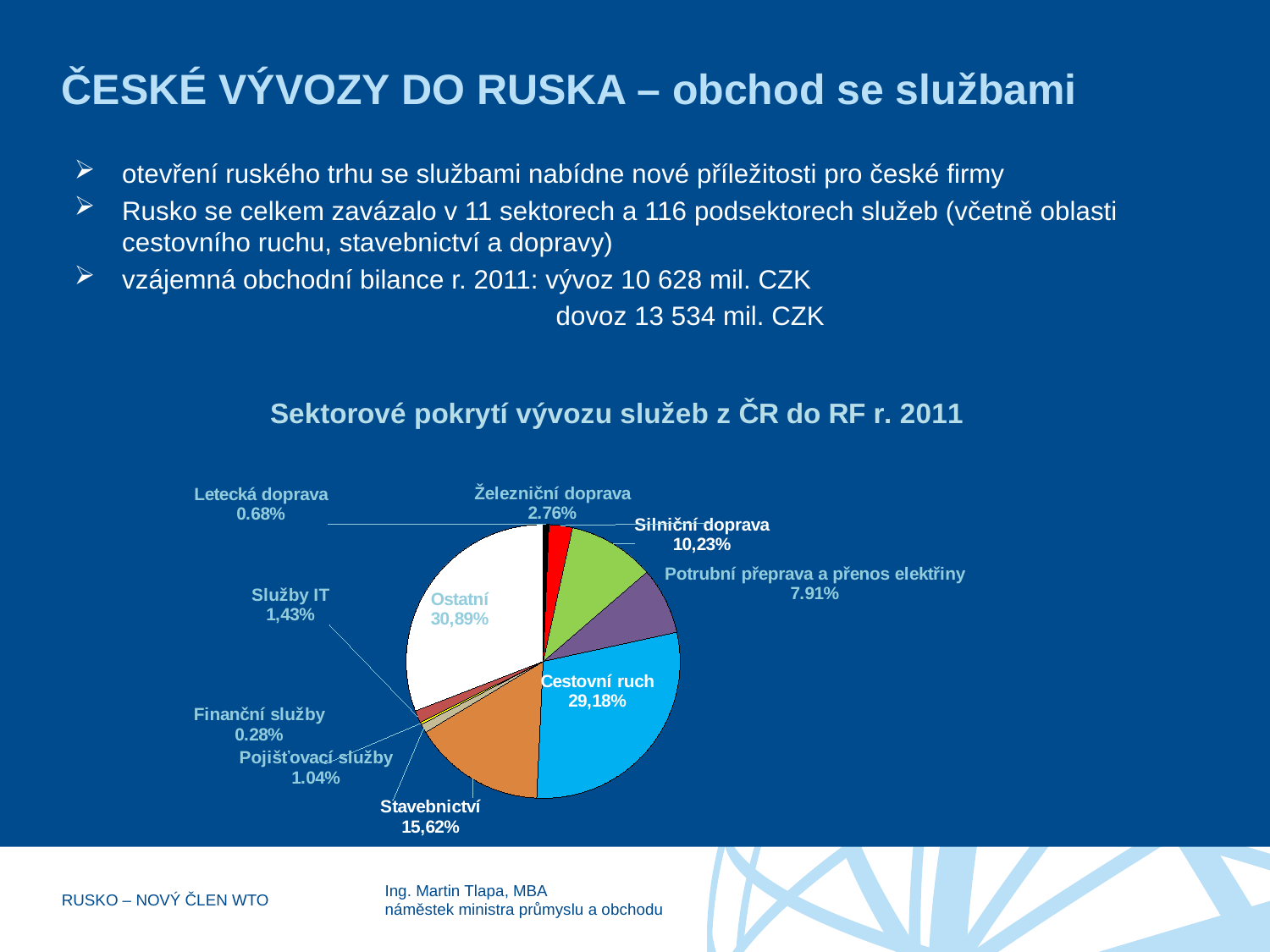
What is the value shown for Silniční doprava? 10,23% What share of the pie does Cestovní ruch have? 29,18% What is the title of the chart on the slide? Sektorové pokrytí vývozu služeb z ČR do RF r. 2011 What kind of chart is shown on the slide? pie chart Which category has the smallest share of the pie? Finanční služby Which category has the largest share of the pie? Ostatní What is the difference between the shares of Stavebnictví and Silniční doprava? 5,39% How many categories (slices) does the pie chart have? 10 What is the value shown for Potrubní přeprava a přenos elektřiny? 7.91% What is the difference between the shares of Cestovní ruch and Stavebnictví? 13,56% Which is larger, the share for Železniční doprava or the share for Letecká doprava? Železniční doprava What is the value shown for Stavebnictví? 15,62%